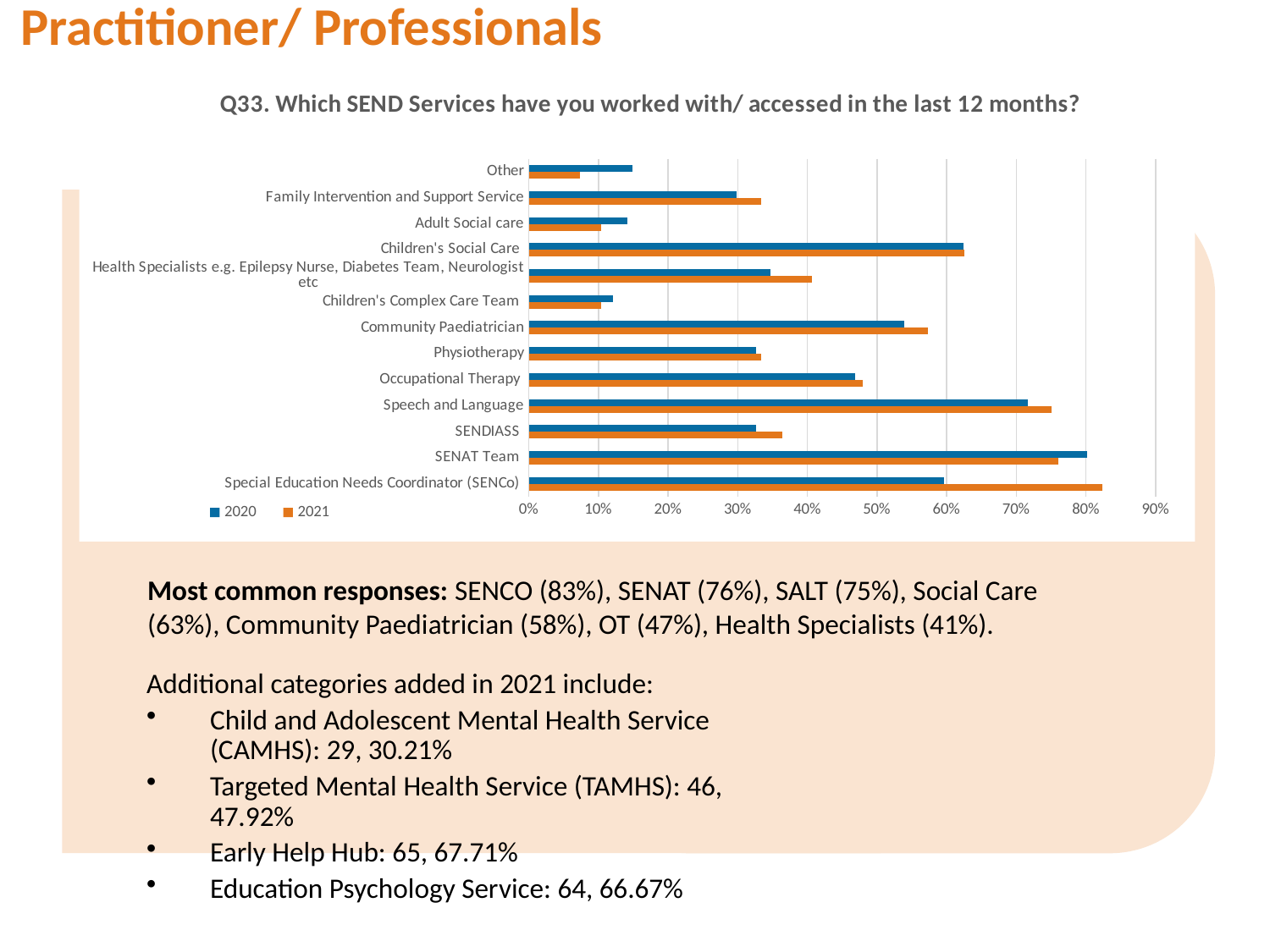
Is the 2021 value for Community Paediatrician greater or less than 50%? greater How many series does the legend list? 2 Which category has the lowest 2021 value? Other What kind of chart is shown on the slide? bar chart Is the 2021 value for Other greater or less than 10%? less Is the 2020 value for Speech and Language greater or less than 70%? greater Which category has the highest 2020 value? SENAT Team How many SEND service categories are plotted on the chart? 13 For SENAT Team, which year has the larger value, 2020 or 2021? 2020 For Health Specialists e.g. Epilepsy Nurse, Diabetes Team, Neurologist etc, which year has the larger value, 2020 or 2021? 2021 Which category has the highest 2021 value? Special Education Needs Coordinator (SENCo)